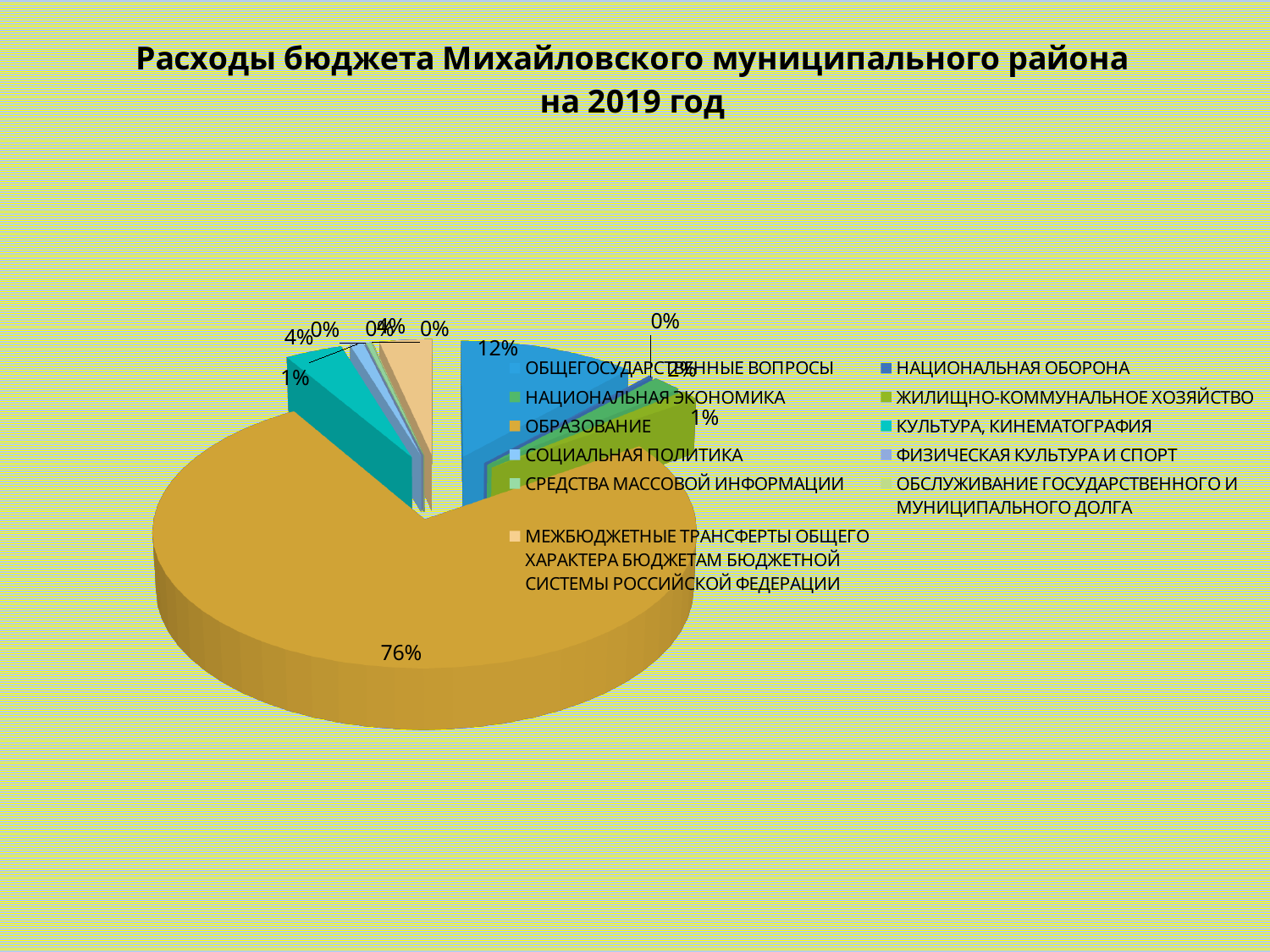
What share of the budget expenditure goes to НАЦИОНАЛЬНАЯ ЭКОНОМИКА? 2% What is the title of the chart? Расходы бюджета Михайловского муниципального района на 2019 год By how many percentage points does the share for ОБРАЗОВАНИЕ exceed the share for ОБЩЕГОСУДАРСТВЕННЫЕ ВОПРОСЫ? 64 percentage points Which category has the largest share of the budget expenditure? ОБРАЗОВАНИЕ Which is larger: the share for ОБРАЗОВАНИЕ or the share for ОБЩЕГОСУДАРСТВЕННЫЕ ВОПРОСЫ? ОБРАЗОВАНИЕ What is the combined share of ОБРАЗОВАНИЕ and ОБЩЕГОСУДАРСТВЕННЫЕ ВОПРОСЫ? 88% What share of the budget expenditure goes to ОБРАЗОВАНИЕ? 76% What share of the budget expenditure goes to ОБЩЕГОСУДАРСТВЕННЫЕ ВОПРОСЫ? 12% What kind of chart is shown on the slide? pie chart Which is larger: the share for ОБЩЕГОСУДАРСТВЕННЫЕ ВОПРОСЫ or the share for НАЦИОНАЛЬНАЯ ЭКОНОМИКА? ОБЩЕГОСУДАРСТВЕННЫЕ ВОПРОСЫ What colour is the slice for ОБРАЗОВАНИЕ? orange How many categories does the legend list? 11